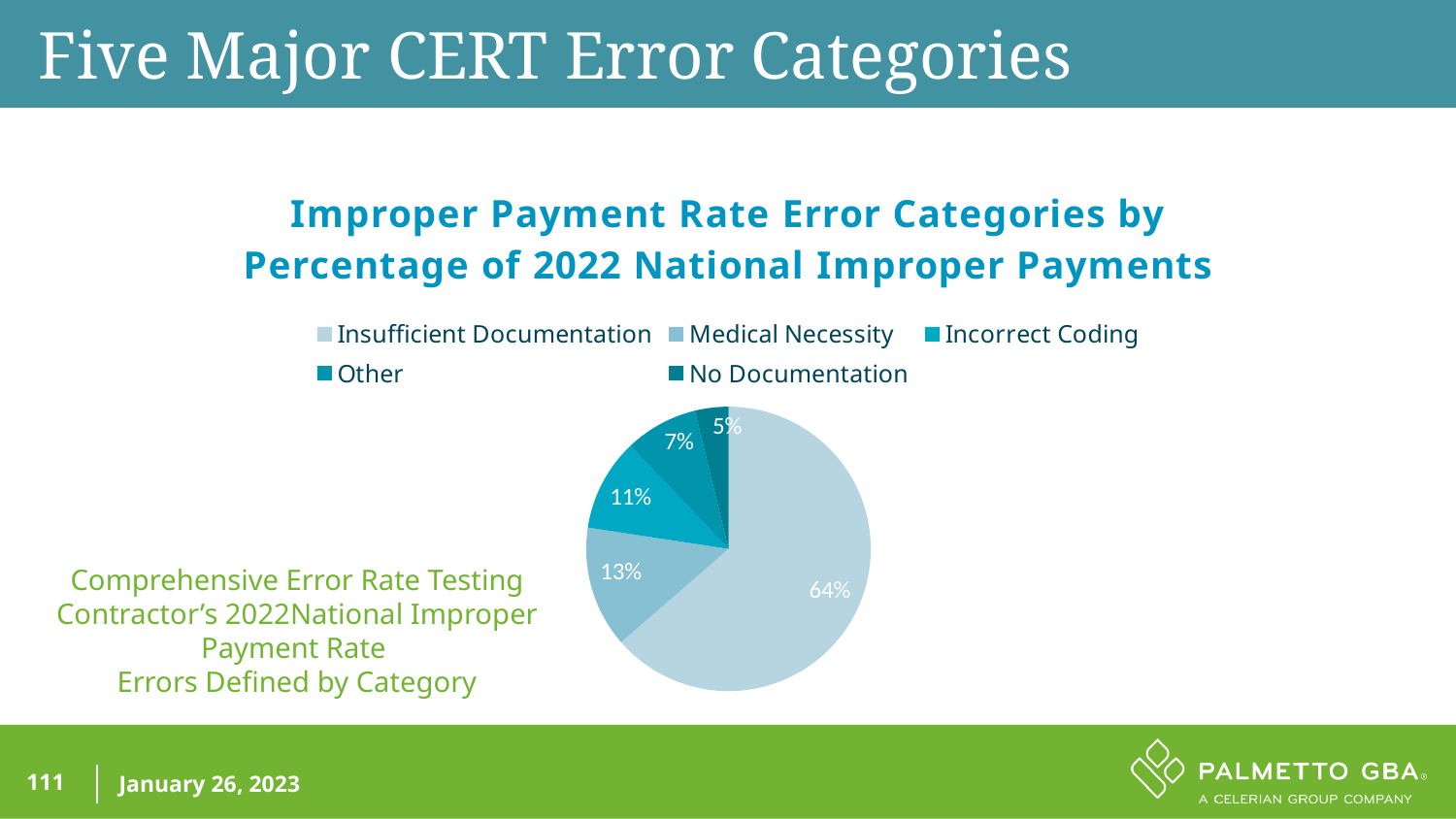
What percentage of 2022 national improper payments is attributed to Insufficient Documentation? 64% What is the combined percentage of Other and No Documentation? 12% How many error categories does the legend list? 5 What is the title of the chart? Improper Payment Rate Error Categories by Percentage of 2022 National Improper Payments What percentage is shown for No Documentation? 5% What percentage is shown for Incorrect Coding? 11% Which is larger, the share for Other or the share for Incorrect Coding? Incorrect Coding Which error category has the largest share of the pie? Insufficient Documentation What is the difference in percentage points between Insufficient Documentation and Medical Necessity? 51 What kind of chart is shown on the slide? pie chart Which error category has the smallest share of the pie? No Documentation What percentage is shown for Medical Necessity? 13%